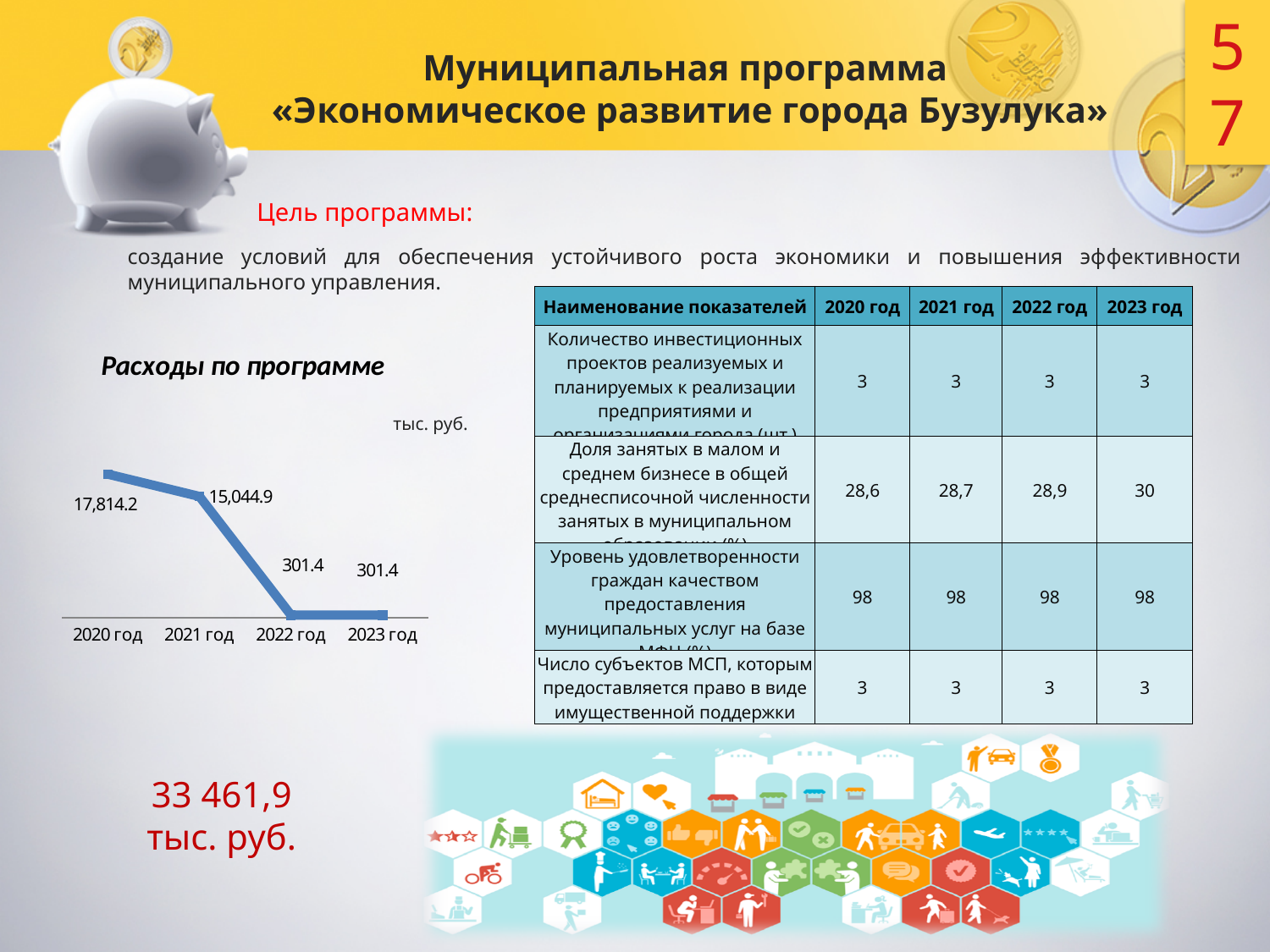
What unit is indicated for the values on the 'Расходы по программе' chart? тыс. руб. What is the value for 2022 год on the 'Расходы по программе' chart? 301.4 Which is larger on the 'Расходы по программе' chart: the value for 2021 год or the value for 2022 год? 2021 год Which year has the highest value on the 'Расходы по программе' chart? 2020 год What is the value for 2023 год on the 'Расходы по программе' chart? 301.4 Do the values on the 'Расходы по программе' chart rise or fall from 2020 год to 2022 год? fall What is the difference between the values for 2021 год and 2022 год on the 'Расходы по программе' chart? 14,743.5 What is the value for 2020 год on the 'Расходы по программе' chart? 17,814.2 How many years are plotted on the 'Расходы по программе' chart? 4 What kind of chart is 'Расходы по программе'? line chart What is the difference between the values for 2020 год and 2021 год on the 'Расходы по программе' chart? 2,769.3 What is the value for 2021 год on the 'Расходы по программе' chart? 15,044.9